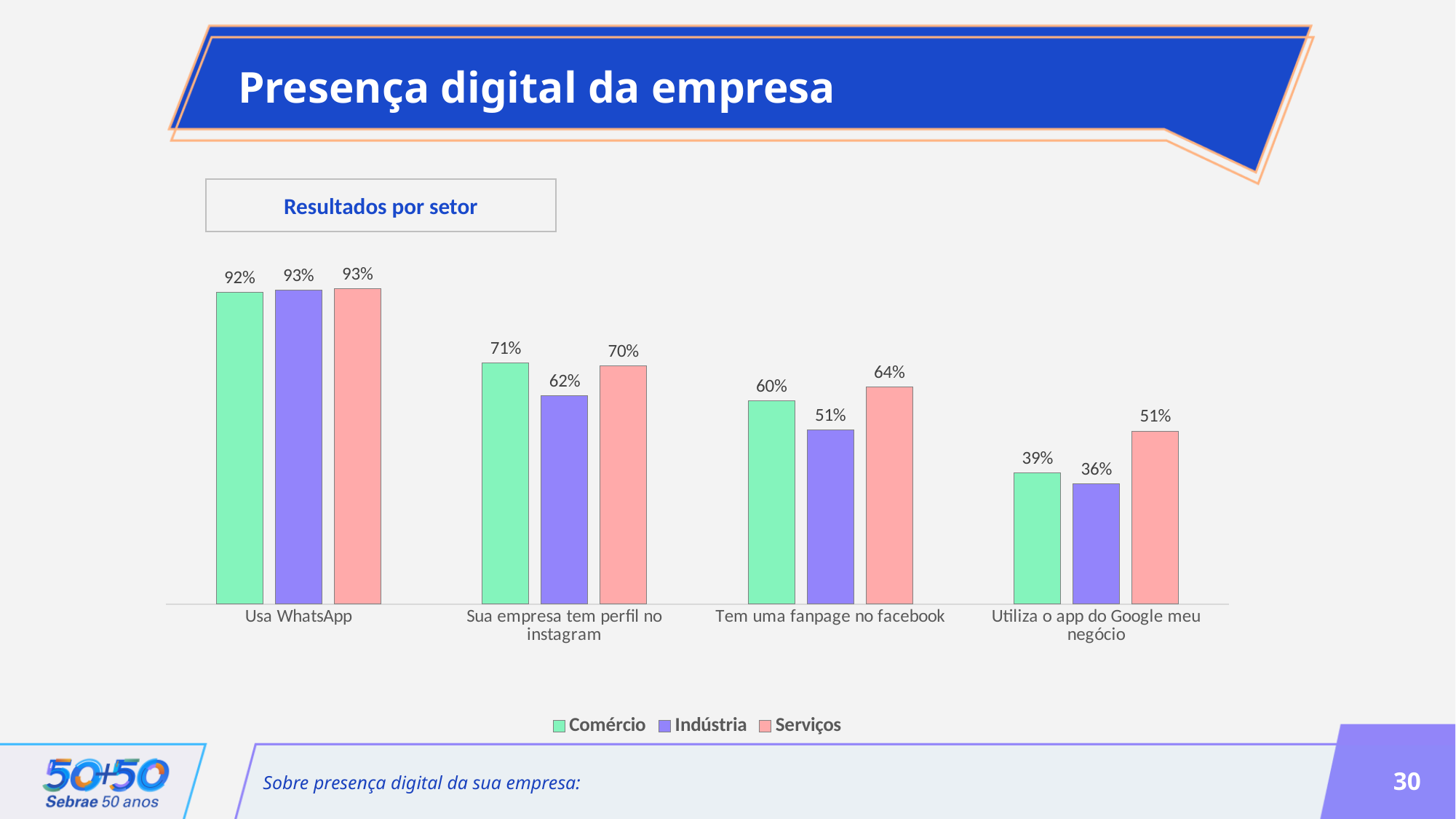
How many categories are shown on the x axis of the chart? 4 How many series does the legend list? 3 Which series has the highest value in the 'Tem uma fanpage no facebook' category? Serviços What is the value for Indústria in the 'Sua empresa tem perfil no instagram' category? 62% Which category has the lowest value for Comércio? Utiliza o app do Google meu negócio Which is larger in the 'Sua empresa tem perfil no instagram' category: Comércio or Serviços? Comércio What is the difference between the Comércio and Indústria values in the 'Tem uma fanpage no facebook' category? 9% What kind of chart is shown on the slide? Bar chart What is the value for Indústria in the 'Utiliza o app do Google meu negócio' category? 36% What is the value for Comércio in the 'Usa WhatsApp' category? 92% What is the value for Serviços in the 'Tem uma fanpage no facebook' category? 64% Do the Serviços values rise or fall from 'Usa WhatsApp' to 'Utiliza o app do Google meu negócio'? Fall